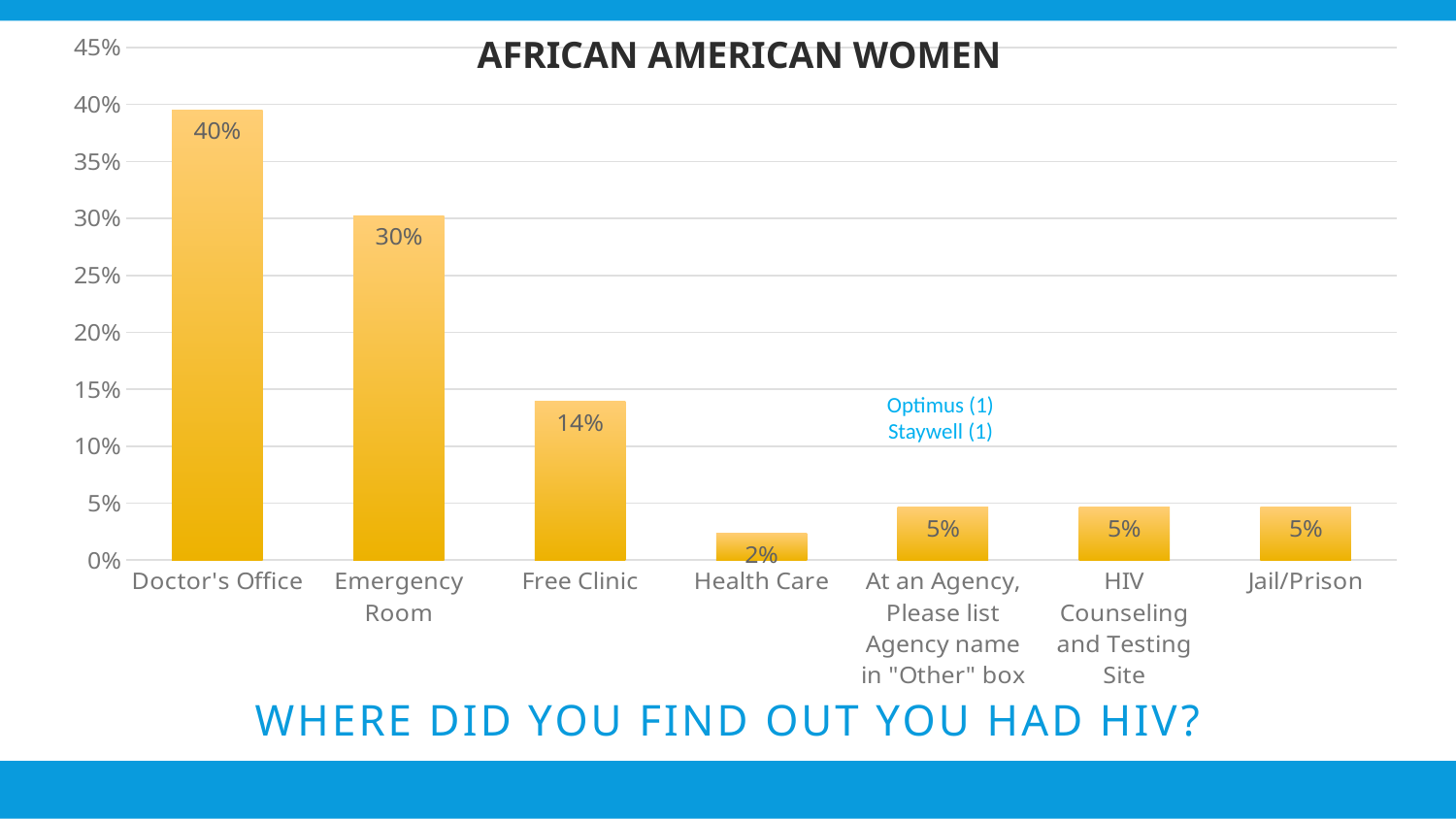
What is the title of the chart? AFRICAN AMERICAN WOMEN What is the value for Emergency Room? 30% What is the difference between the Doctor's Office and Emergency Room values? 10% What is the value for Free Clinic? 14% What percentage of African American women found out they had HIV at a Doctor's Office? 40% How many categories are shown on the x axis? 7 Which category has the highest value? Doctor's Office What is the value for Jail/Prison? 5% Which is larger, the value for Free Clinic or the value for HIV Counseling and Testing Site? Free Clinic What kind of chart is this? Bar chart What is the value for Health Care? 2% Which category has the lowest value? Health Care